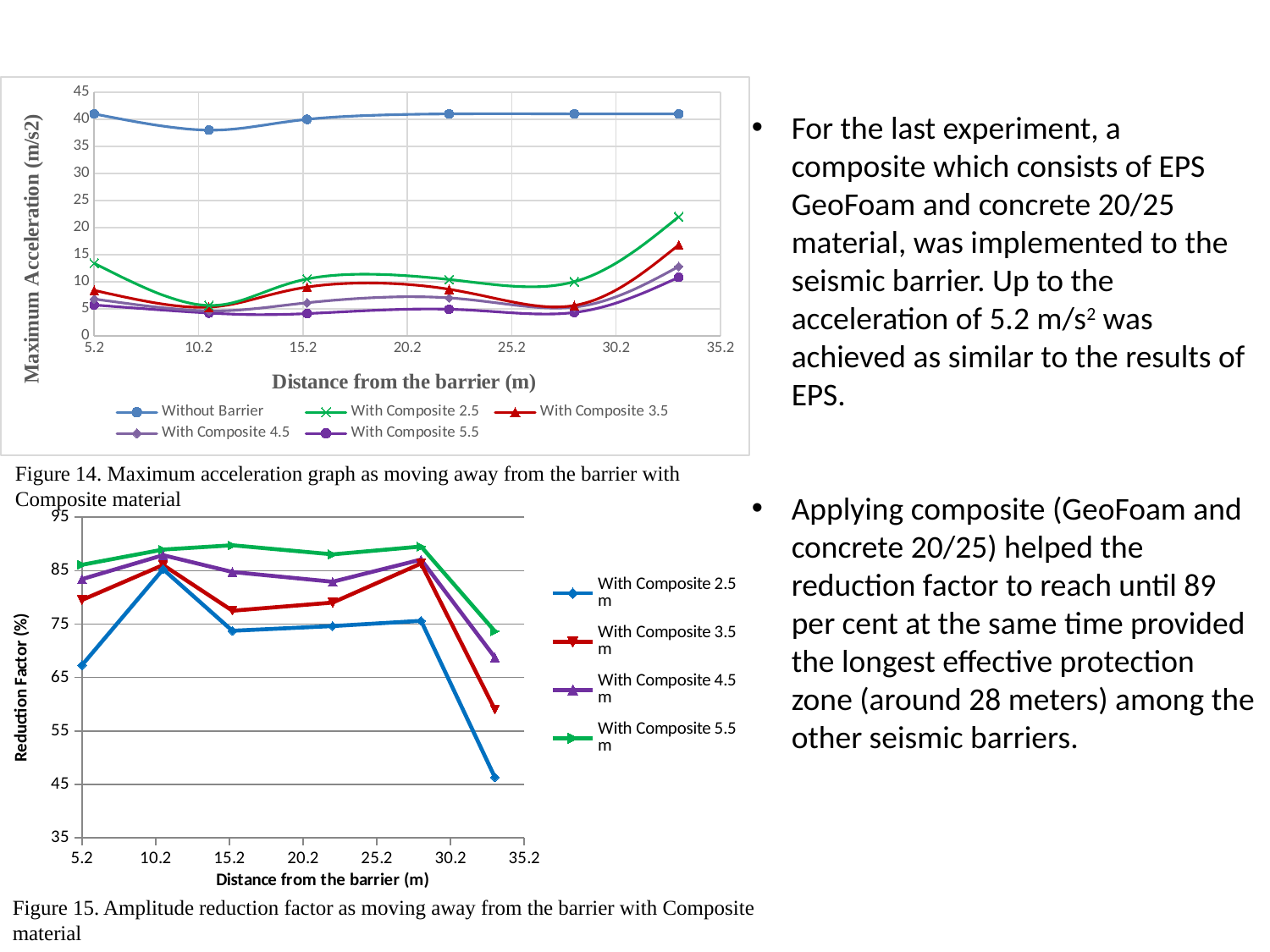
In the top chart (Figure 14), is the value for Without Barrier at 10.2 m greater or less than 40? less In the top chart (Figure 14), at the farthest distance plotted, which is larger: With Composite 2.5 or With Composite 3.5? With Composite 2.5 In the top chart (Figure 14), how many series does the legend list? 5 In the bottom chart (Figure 15), how many series does the legend list? 4 In the top chart (Figure 14), what kind of chart is shown? line chart In the bottom chart (Figure 15), is the value for With Composite 2.5 m at the farthest distance plotted greater or less than 55? less In the bottom chart (Figure 15), does the With Composite 2.5 m line rise or fall between the last two plotted distances? fall In the top chart (Figure 14), which series has the highest maximum acceleration across all distances? Without Barrier In the top chart (Figure 14), what is the label of the y axis? Maximum Acceleration (m/s2) In the bottom chart (Figure 15), at 15.2 m, which is larger: With Composite 5.5 m or With Composite 2.5 m? With Composite 5.5 m In the top chart (Figure 14), is the value for With Composite 2.5 at the farthest distance plotted greater or less than 20? greater In the bottom chart (Figure 15), which series has the lowest reduction factor at the farthest distance plotted? With Composite 2.5 m